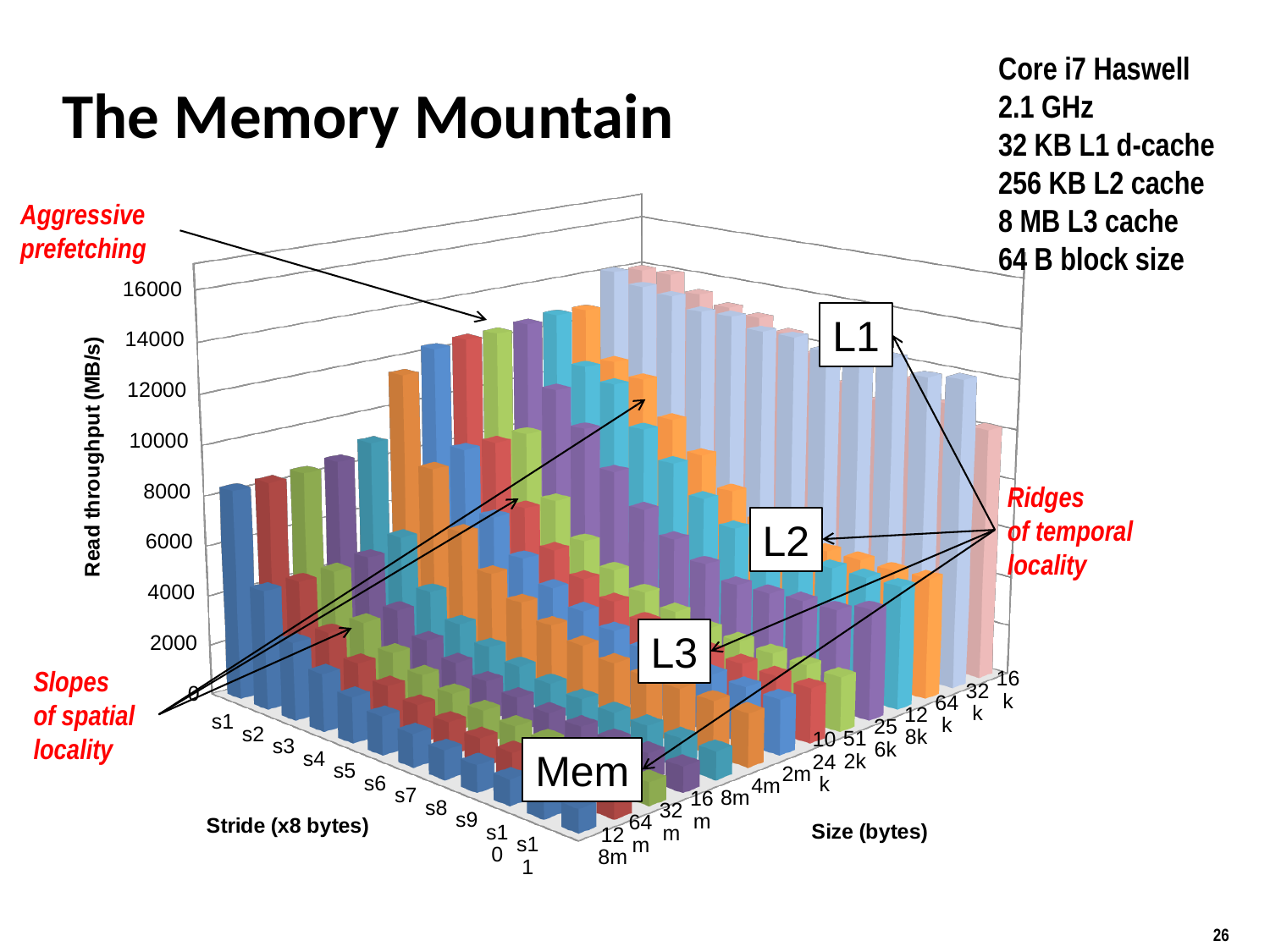
What is the title of the chart on the slide? The Memory Mountain Is the read throughput for stride s11 at size 128m greater or less than 2000? less What kind of chart is shown on the slide? bar chart Is the read throughput for stride s1 at size 16k greater or less than 10000? greater How many stride categories (s1 through s11) are shown on the stride axis? 11 Which size has the lowest read throughput at stride s1, 16k or 128m? 128m What is the highest tick value shown on the read throughput axis? 16000 Which is larger, the read throughput for stride s1 at size 16k or for stride s1 at size 128m? stride s1 at size 16k What is the label of the vertical axis of the chart? Read throughput (MB/s) For size 128m, does read throughput rise or fall as the stride increases from s1 to s11? fall